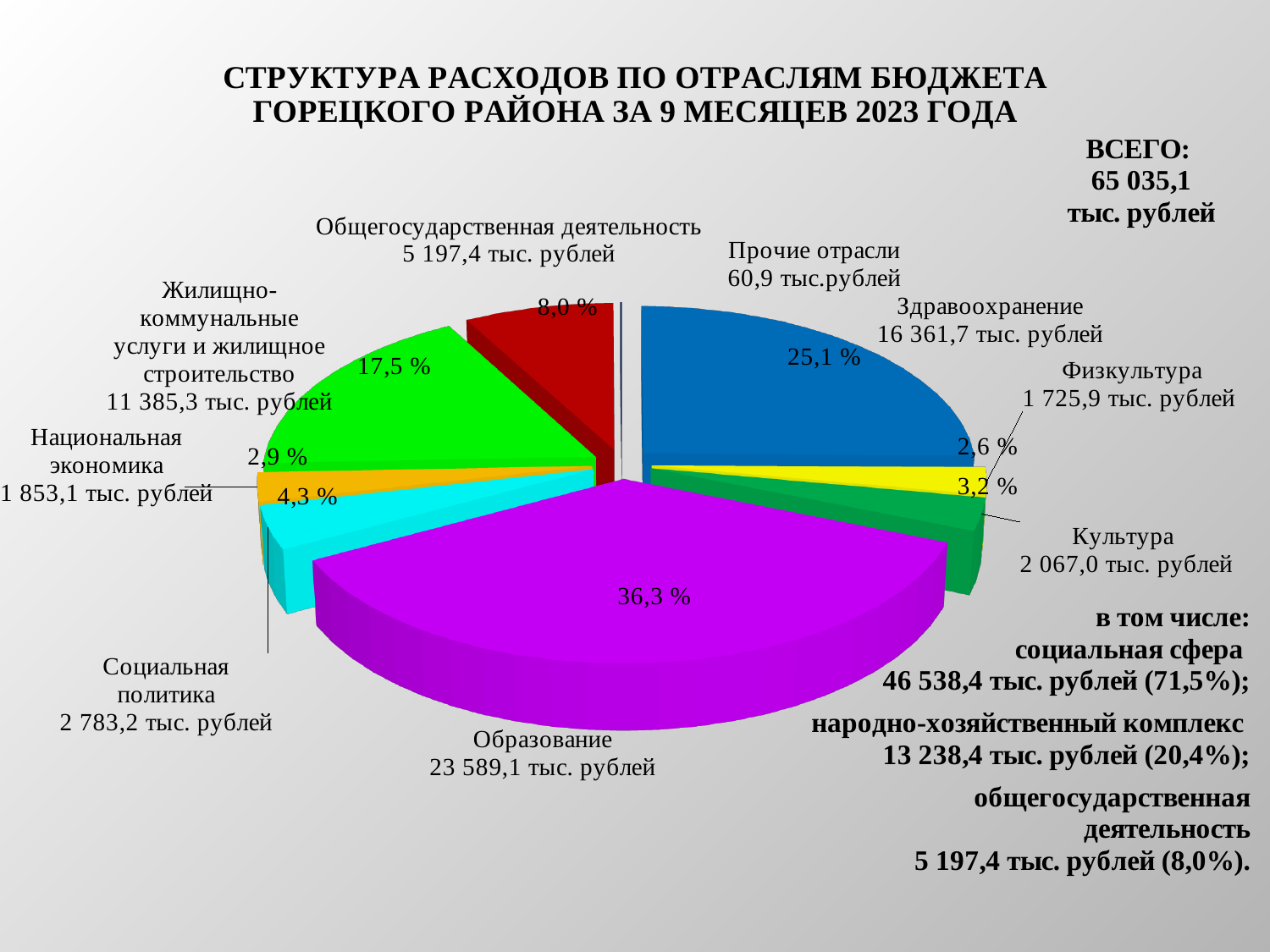
What type of chart is shown on the slide? pie chart Which category has the largest share of the pie? Образование What is the value for Жилищно-коммунальные услуги и жилищное строительство? 11 385,3 тыс. рублей How many categories (slices) does the pie chart show? 9 What share of the pie does Физкультура represent? 2,6 % What is the difference between the values for Образование and Здравоохранение? 7 227,4 тыс. рублей What is the value for Образование? 23 589,1 тыс. рублей What is the value for Прочие отрасли? 60,9 тыс.рублей Which is larger, Здравоохранение or Жилищно-коммунальные услуги и жилищное строительство? Здравоохранение What share of the pie does Образование represent? 36,3 % Which category has the smallest value? Прочие отрасли What is the value for Здравоохранение? 16 361,7 тыс. рублей